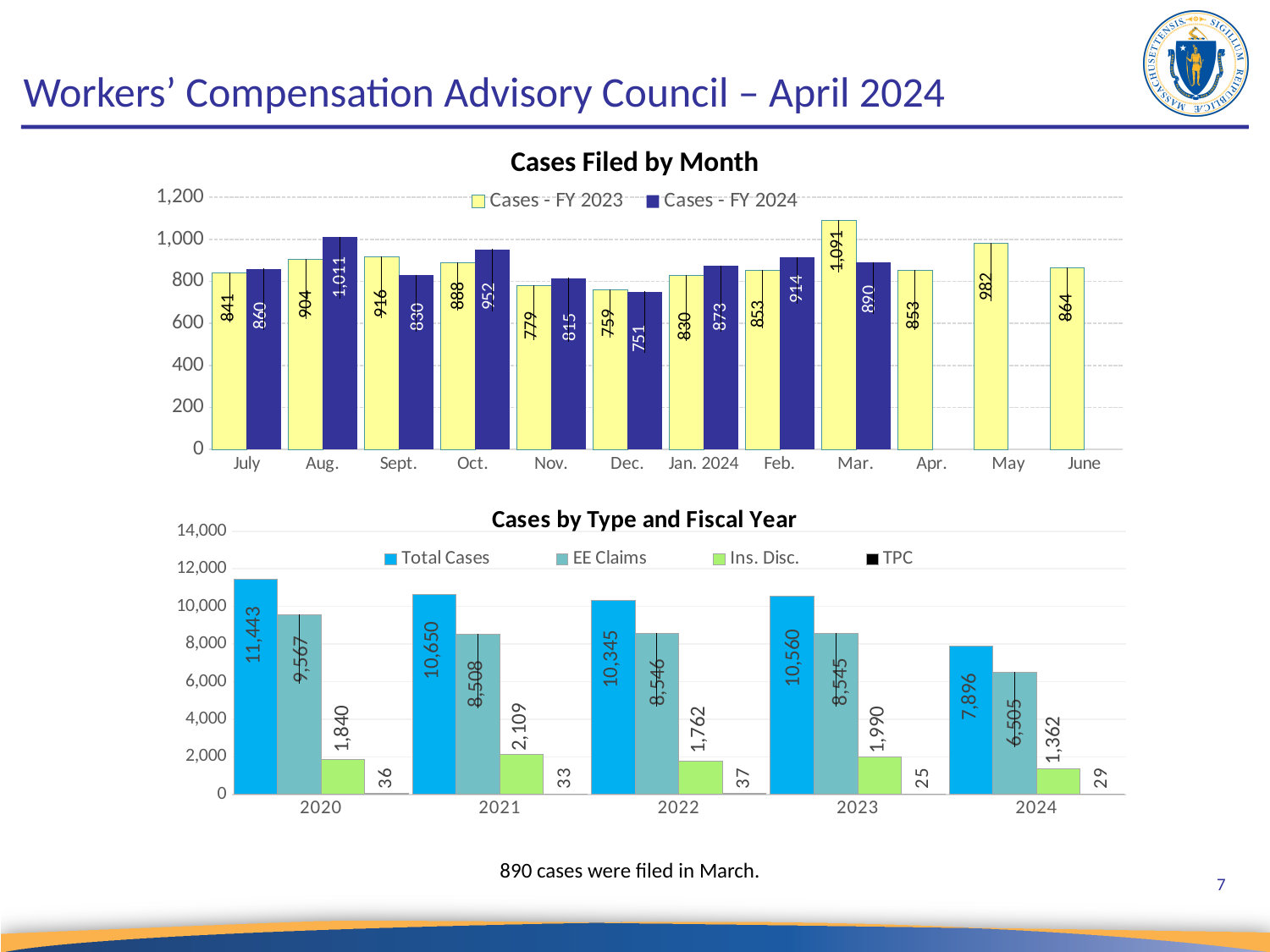
In the 'Cases by Type and Fiscal Year' chart, which year has the highest Ins. Disc. value? 2021 In the 'Cases by Type and Fiscal Year' chart, what is the Total Cases value for 2022? 10,345 In the 'Cases Filed by Month' chart, which is larger for September: the FY 2023 value or the FY 2024 value? FY 2023 In the 'Cases Filed by Month' chart, what is the difference between the FY 2023 and FY 2024 values for March? 201 In the 'Cases Filed by Month' chart, which month has the highest FY 2023 value? Mar. What kind of chart is 'Cases by Type and Fiscal Year'? Bar chart In the 'Cases Filed by Month' chart, which month has the lowest FY 2024 value? Dec. In the 'Cases Filed by Month' chart, how many cases were filed in August for FY 2024? 1,011 In the 'Cases Filed by Month' chart, how many series does the legend list? 2 In the 'Cases by Type and Fiscal Year' chart, how many fiscal years are shown on the x axis? 5 In the 'Cases by Type and Fiscal Year' chart, what is the difference between Total Cases in 2020 and 2024? 3,547 In the 'Cases by Type and Fiscal Year' chart, what is the TPC value for 2023? 25